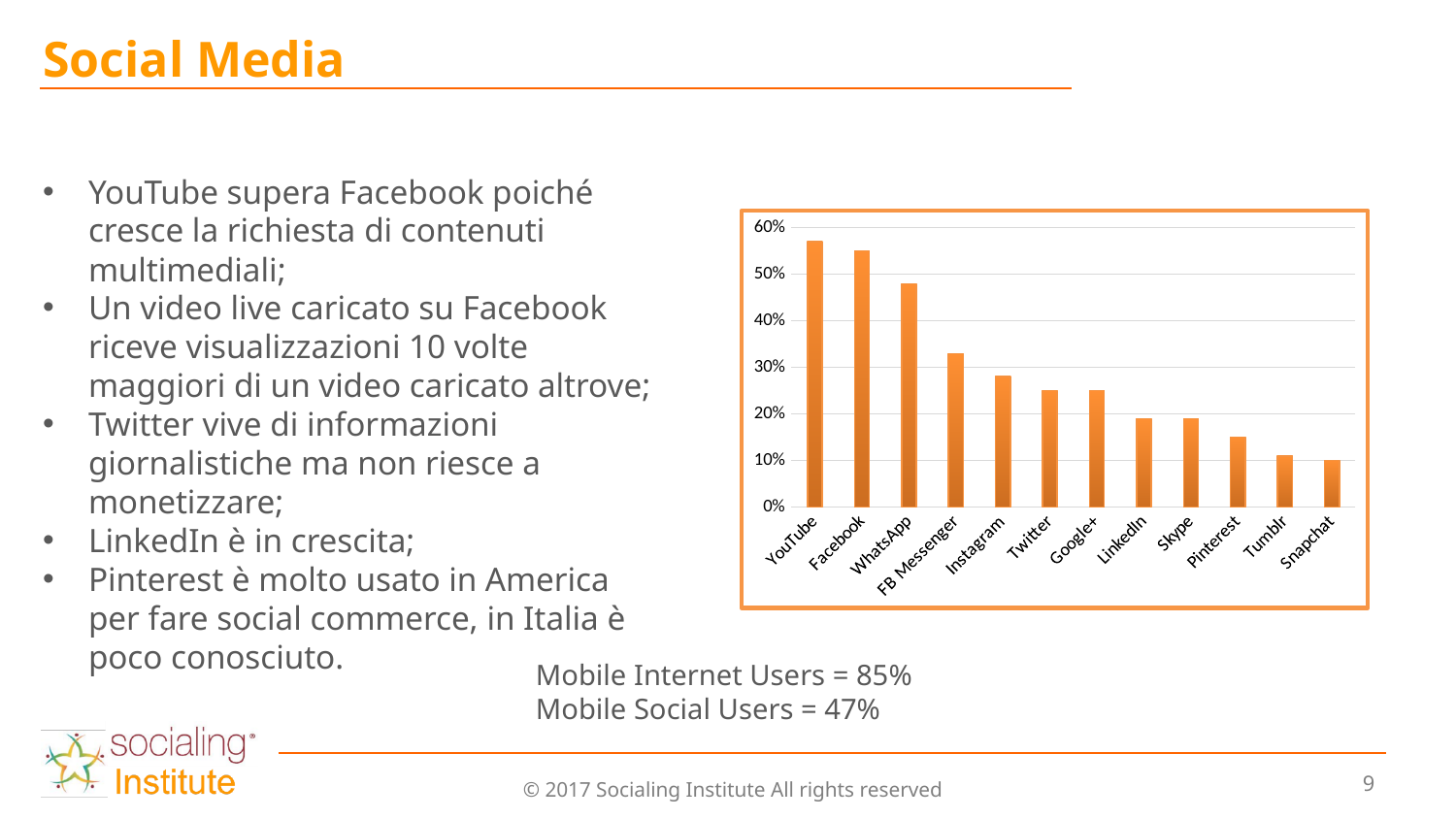
Which has a larger value, Twitter or Pinterest? Twitter Is the value for WhatsApp greater or less than 40%? greater Which has a larger value, WhatsApp or Instagram? WhatsApp How many platforms are shown on the x axis of the chart? 12 Do the values rise or fall moving from left to right along the x axis? fall Is the value for Pinterest greater or less than 20%? less Which platform has the highest value in the chart? YouTube Is the value for Instagram greater or less than 30%? less What kind of chart is shown on the slide? bar chart